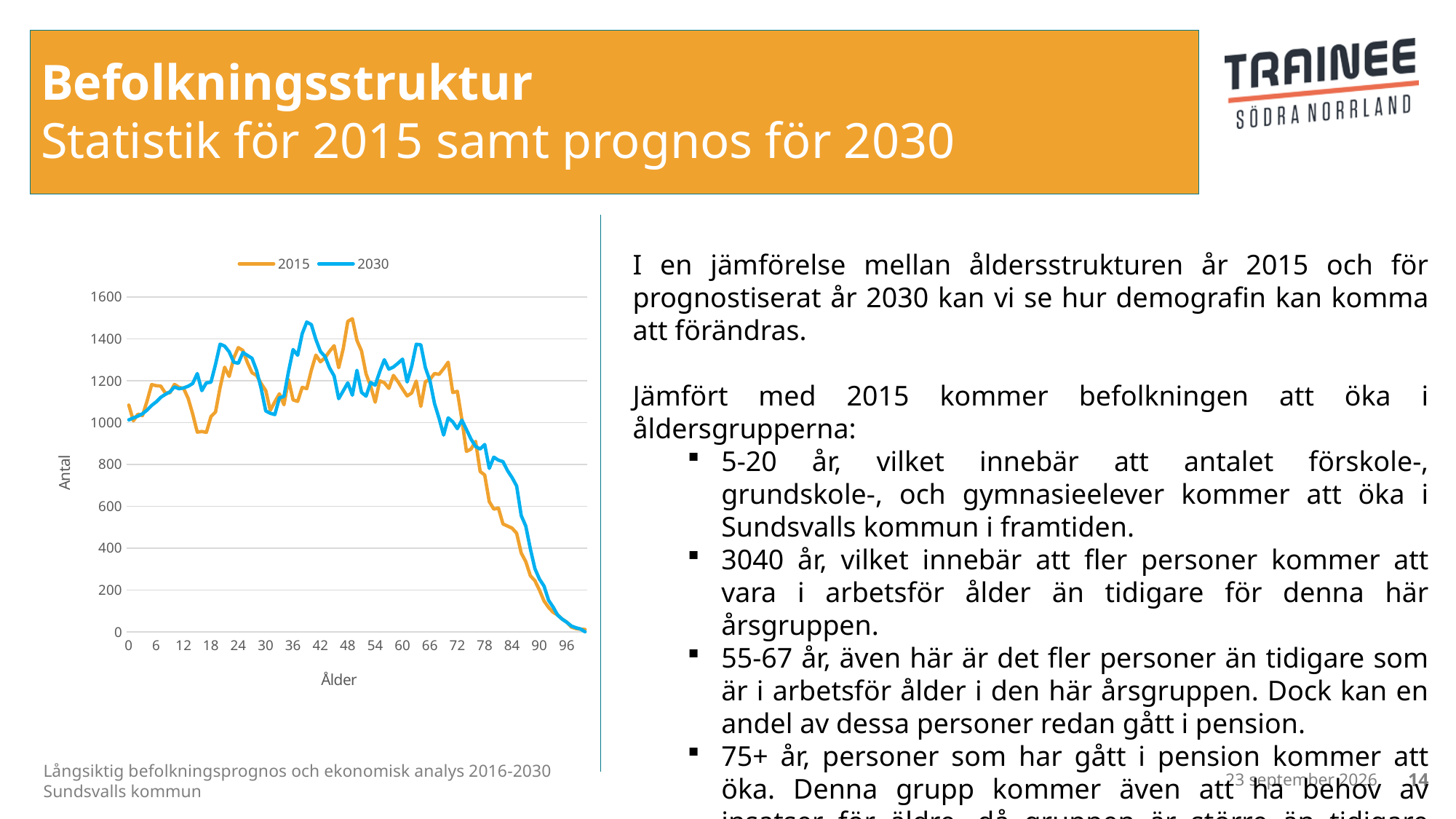
Is the value of the 2030 series at age 84 greater or less than 600? greater Is the value of the 2030 series at age 40 greater or less than 1400? greater At age 48, which series has the larger value, 2015 or 2030? 2015 How many series does the chart legend list? 2 What are the two series named in the chart legend? 2015 and 2030 What is the label of the vertical axis of the chart? Antal At age 84, which series has the larger value, 2015 or 2030? 2030 Do the values of both series rise or fall as age increases from 78 to 96? fall Is the value of the 2015 series at age 48 greater or less than 1400? greater What kind of chart is shown on the slide? line chart